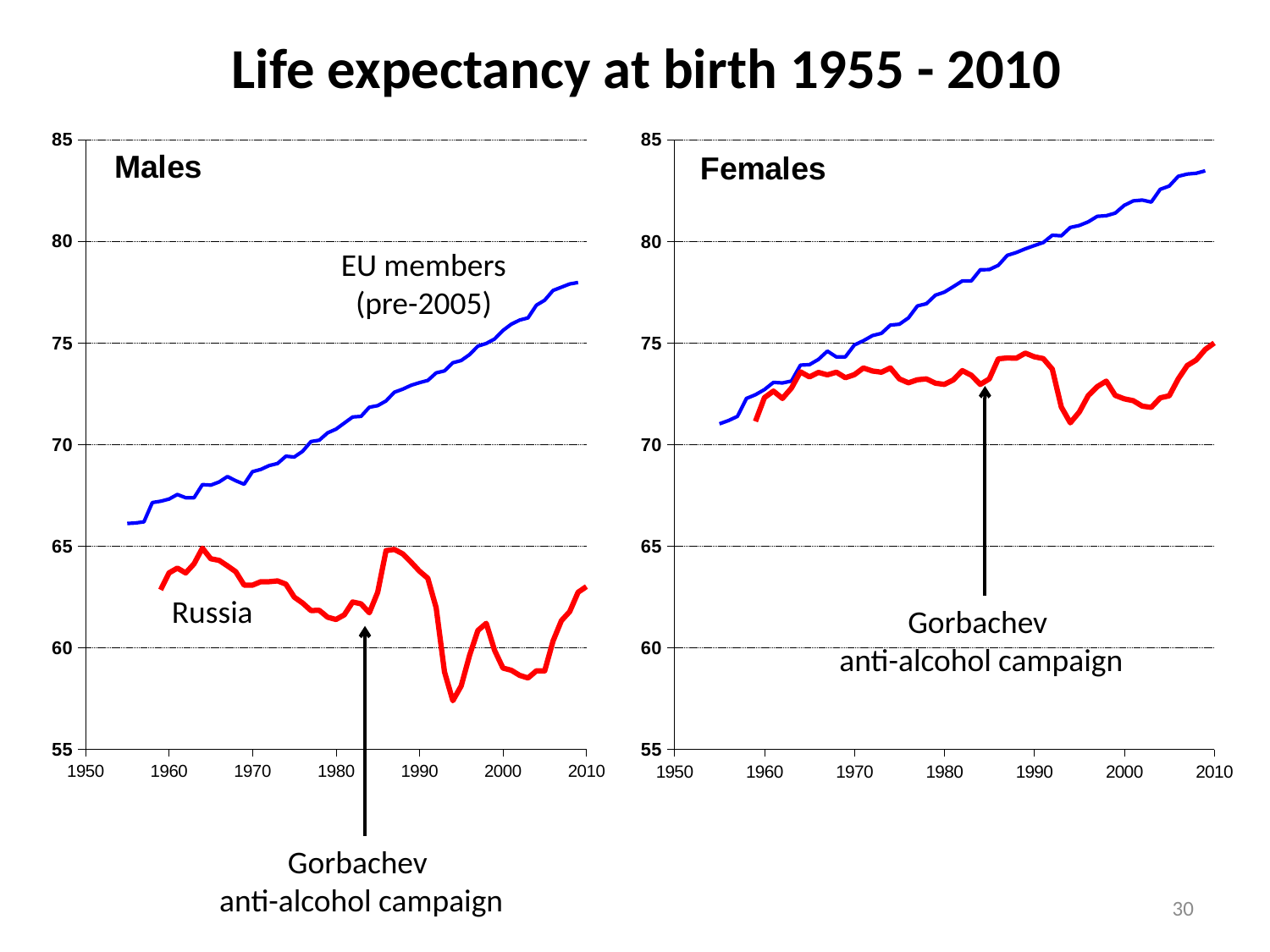
In the Females chart, is the value for EU members (pre-2005) in 2010 greater or less than 80? greater In the Males chart, is the value for Russia around 1994 greater or less than 60? less What event do the arrows on both charts point to? Gorbachev anti-alcohol campaign What is the title of the slide's charts? Life expectancy at birth 1955 - 2010 In the Females chart, do the values for EU members (pre-2005) rise or fall over time? rise In the Females chart, is the value for Russia in 1980 greater or less than 70? greater In the Males chart, do the values for EU members (pre-2005) rise or fall from 1955 to 2010? rise In the Females chart, which series has the higher value in 2005, EU members (pre-2005) or Russia? EU members (pre-2005) What kind of chart is the Males chart? line chart How many series are plotted in the Males chart? 2 In the Males chart, which series has the higher value in 2000, EU members (pre-2005) or Russia? EU members (pre-2005)